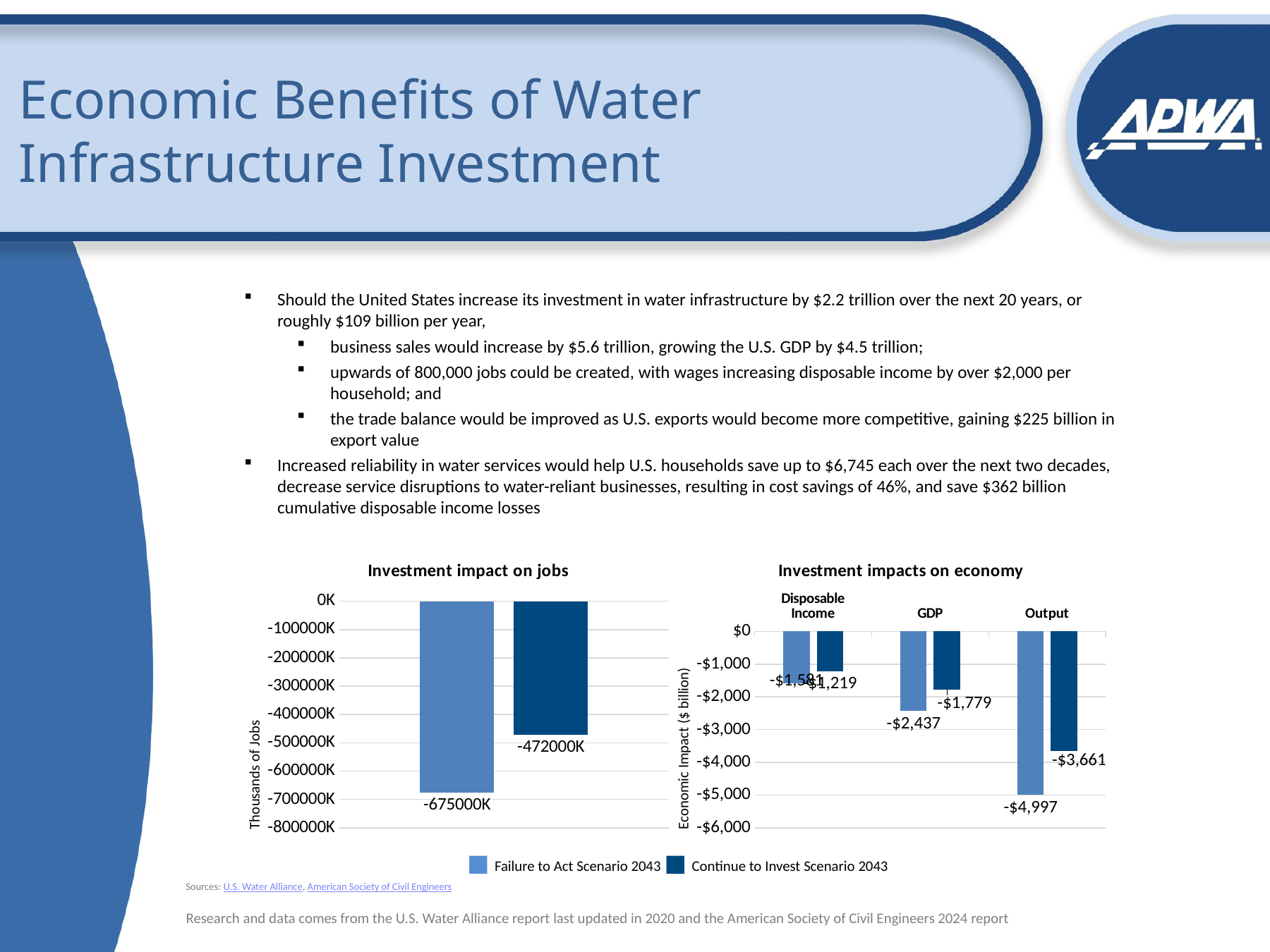
In the 'Investment impacts on economy' chart, which category has the lowest (most negative) value? Output In the 'Investment impacts on economy' chart, what is the GDP value for the Failure to Act Scenario 2043? -$2,437 In the 'Investment impact on jobs' chart, what is the value for the Continue to Invest Scenario 2043? -472000K In the 'Investment impacts on economy' chart, is the Failure to Act Scenario 2043 value for Output greater or less than -$4,000? less In the 'Investment impact on jobs' chart, what is the difference between the Failure to Act Scenario 2043 and Continue to Invest Scenario 2043 values? 203000K In the 'Investment impact on jobs' chart, what is the value for the Failure to Act Scenario 2043? -675000K What type of chart is the 'Investment impact on jobs' chart? Bar chart In the 'Investment impacts on economy' chart, what is the Output value for the Continue to Invest Scenario 2043? -$3,661 In the 'Investment impacts on economy' chart, what is the Disposable Income value for the Continue to Invest Scenario 2043? -$1,219 How many series does the legend list for the charts on the slide? 2 In the 'Investment impacts on economy' chart, what is the difference between the Failure to Act and Continue to Invest values for Output? $1,336 How many categories are shown on the x axis of the 'Investment impacts on economy' chart? 3